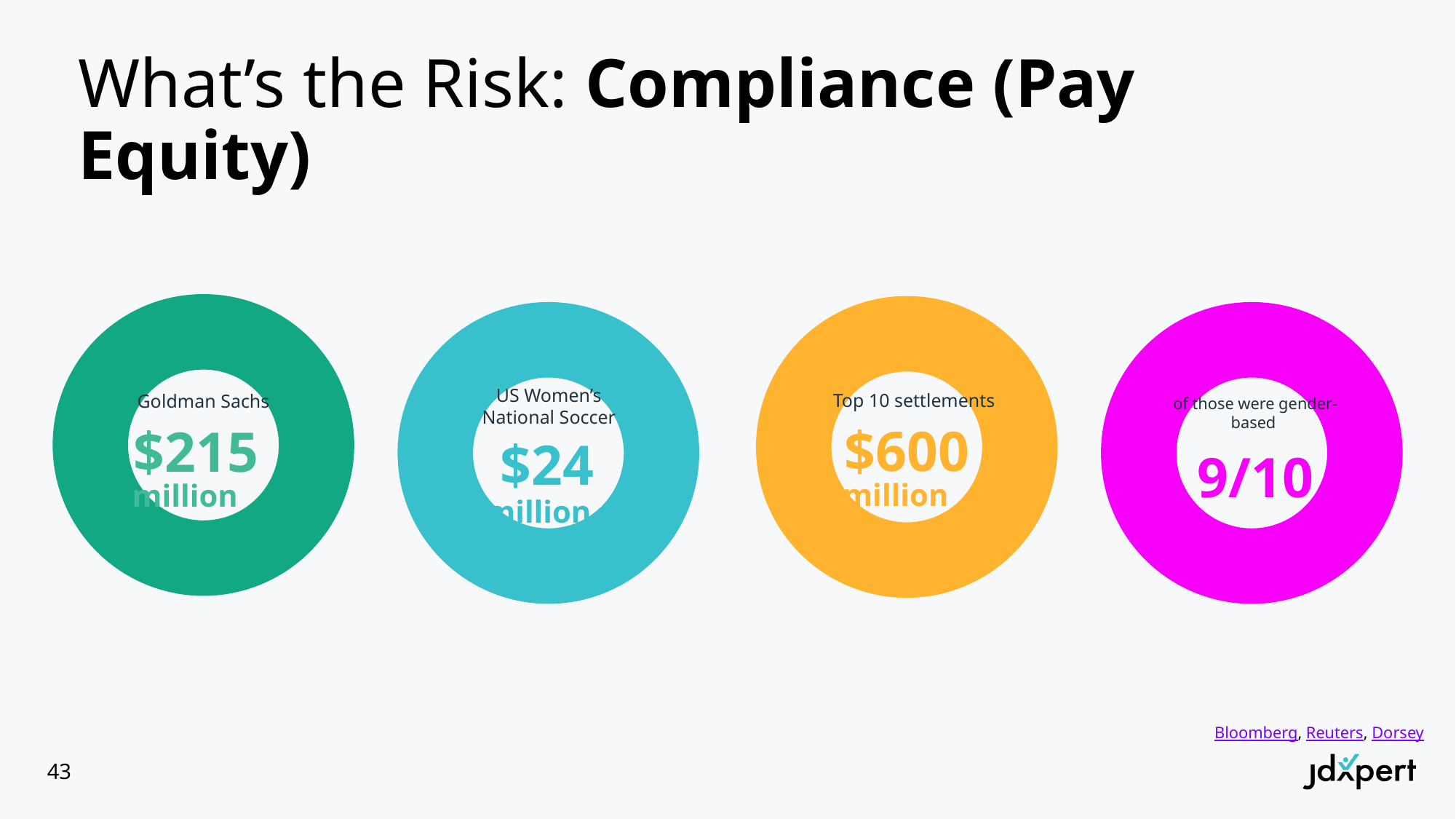
Which of the three dollar figures shown is the smallest? US Women's National Soccer Which of the three dollar figures shown is the largest? Top 10 settlements How many circles are shown on the slide? 4 What fraction of the settlements is shown as gender-based? 9/10 What colour is the circle containing the 9/10 figure? Magenta What is the difference between the Goldman Sachs figure and the US Women's National Soccer figure? $191 million What colour is the circle containing the Goldman Sachs figure? Green Which is larger, the Goldman Sachs figure or the US Women's National Soccer figure? Goldman Sachs What value is shown for the Top 10 settlements? $600 million What value is shown in the Goldman Sachs circle? $215 million What value is shown in the US Women's National Soccer circle? $24 million